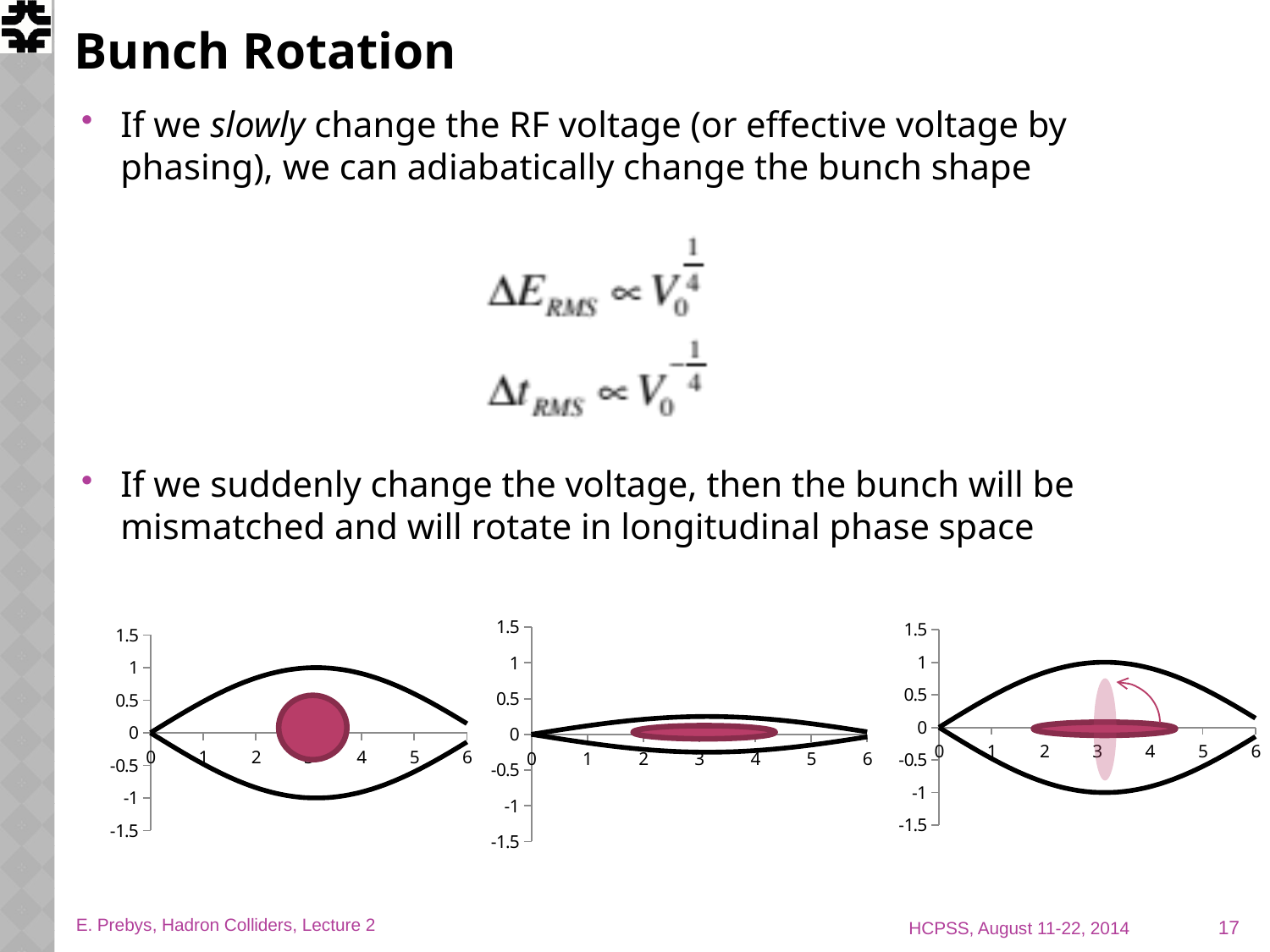
What kind of chart is the leftmost chart at the bottom of the slide? line chart In the leftmost chart, what is the highest value labelled on the vertical axis? 1.5 In the leftmost chart, what is the lowest value labelled on the vertical axis? -1.5 How many charts are shown at the bottom of the slide? 3 In the middle chart, is the black curve's value at x = 3 greater or less than 1? less In the middle chart, is the maximum height of the black curve greater or less than 0.5? less In the rightmost chart, is the minimum of the lower black curve greater or less than -0.5? less Which chart has the black curve with the smaller maximum height, the leftmost chart or the middle chart? the middle chart In the middle chart, what is the largest value labelled on the horizontal axis? 6